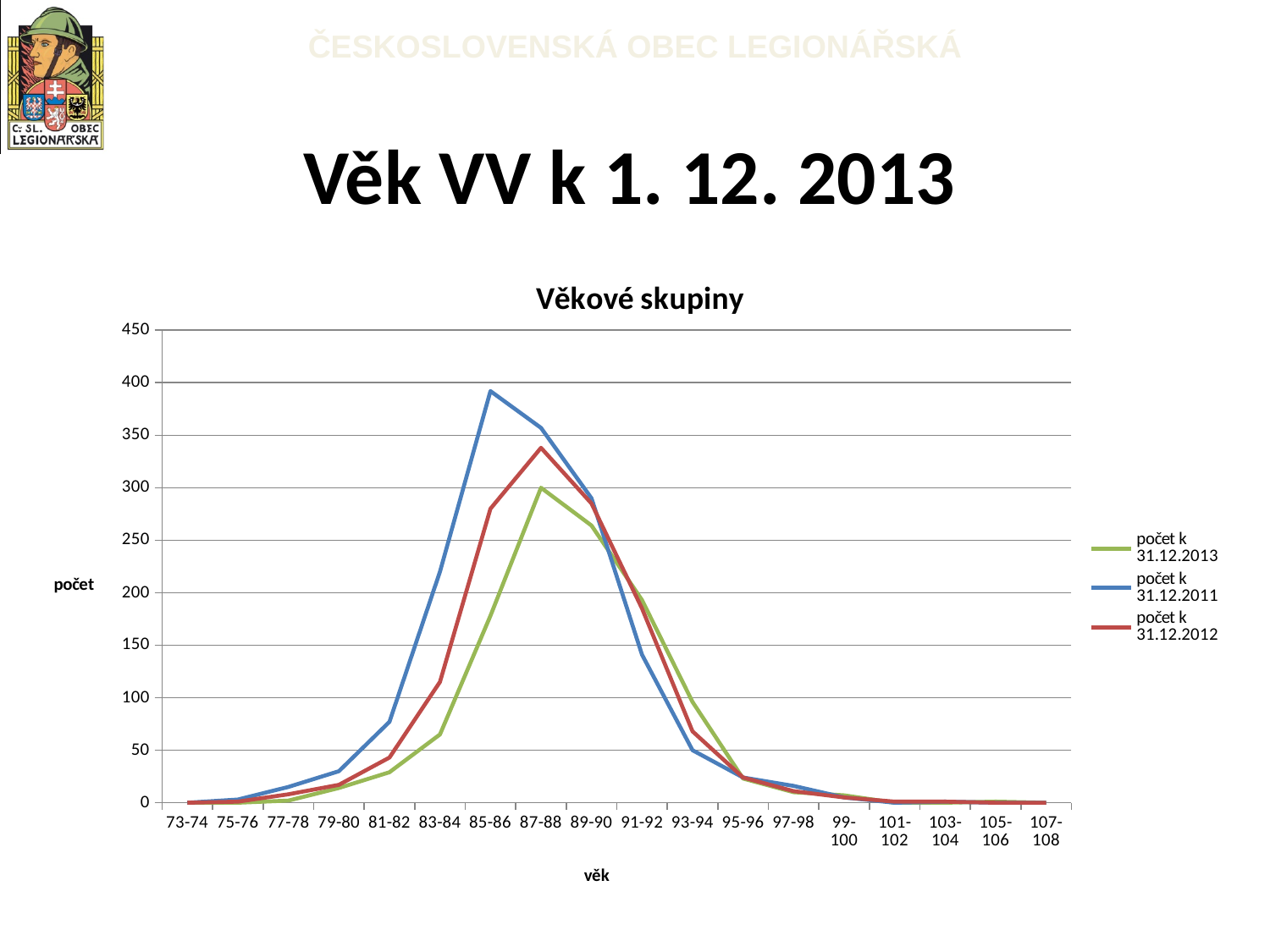
Is the value for 'počet k 31.12.2013' at age group 85-86 greater or less than 200? less In which age group does the 'počet k 31.12.2011' series reach its highest value? 85-86 Is the value for 'počet k 31.12.2012' at age group 87-88 greater or less than 300? greater How many series does the legend list? 3 What is the title of the chart? Věkové skupiny At age group 85-86, which series has the larger value: 'počet k 31.12.2011' or 'počet k 31.12.2013'? počet k 31.12.2011 Is the value for 'počet k 31.12.2011' at age group 85-86 greater or less than 350? greater Does the 'počet k 31.12.2013' series rise or fall from age group 87-88 to 95-96? fall What is the label of the vertical axis? počet What kind of chart is shown on the slide? line chart In which age group does the 'počet k 31.12.2012' series reach its highest value? 87-88 How many age groups are shown on the x axis? 18